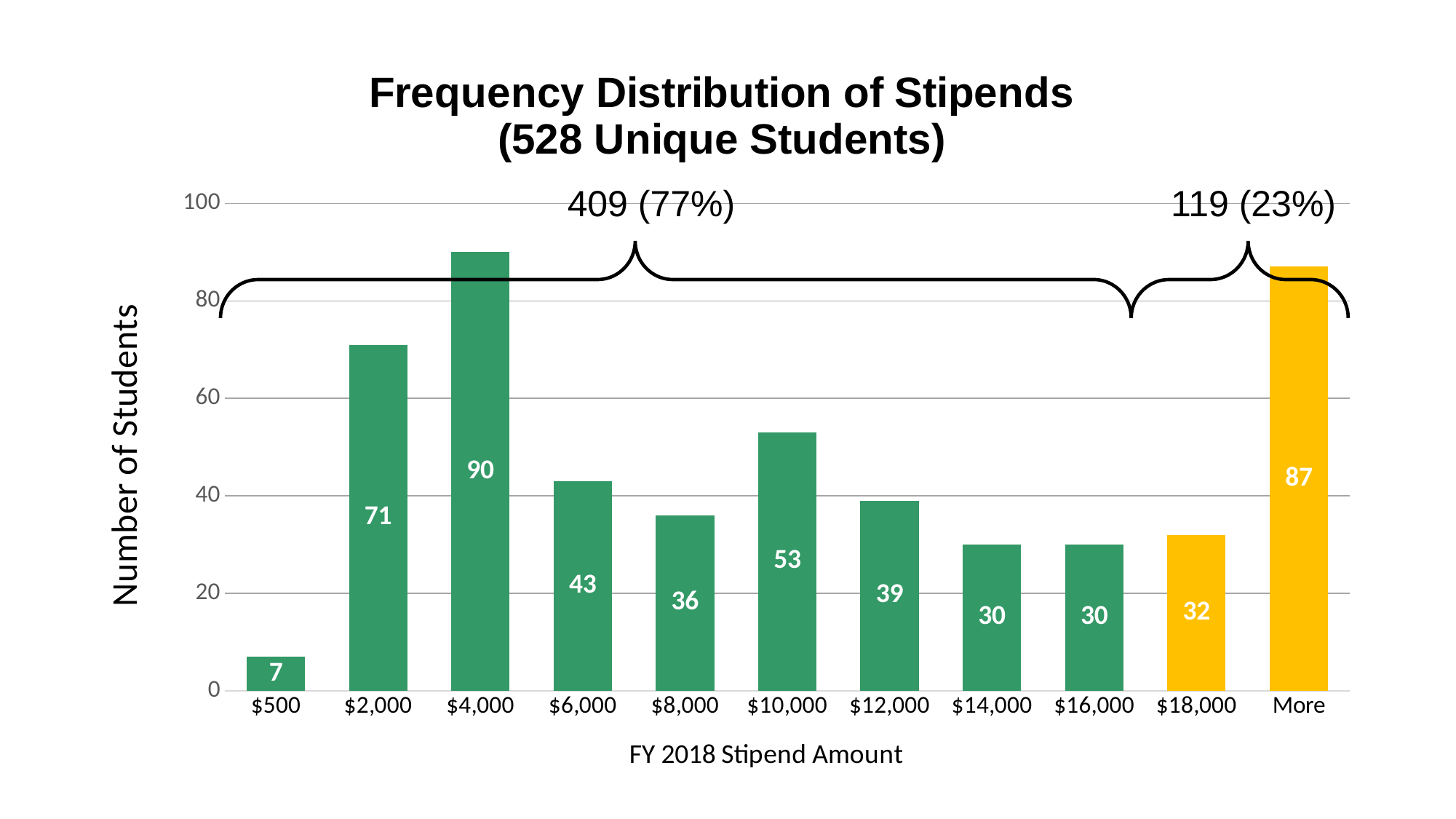
What kind of chart is shown on the slide? bar chart How many students are in the 'More' category? 87 Which has more students, the $10,000 stipend amount or the $12,000 stipend amount? $10,000 Which stipend amount has the lowest number of students? $500 What is the number of students for the $500 stipend amount? 7 How many stipend amount categories are shown on the x axis? 11 What is the title of the chart? Frequency Distribution of Stipends (528 Unique Students) Is the value for $8,000 greater or less than 40? less What is the difference in number of students between the $2,000 and $6,000 stipend amounts? 28 What is the label on the x axis of the chart? FY 2018 Stipend Amount How many students received a stipend of $4,000? 90 Which stipend amount has the highest number of students? $4,000